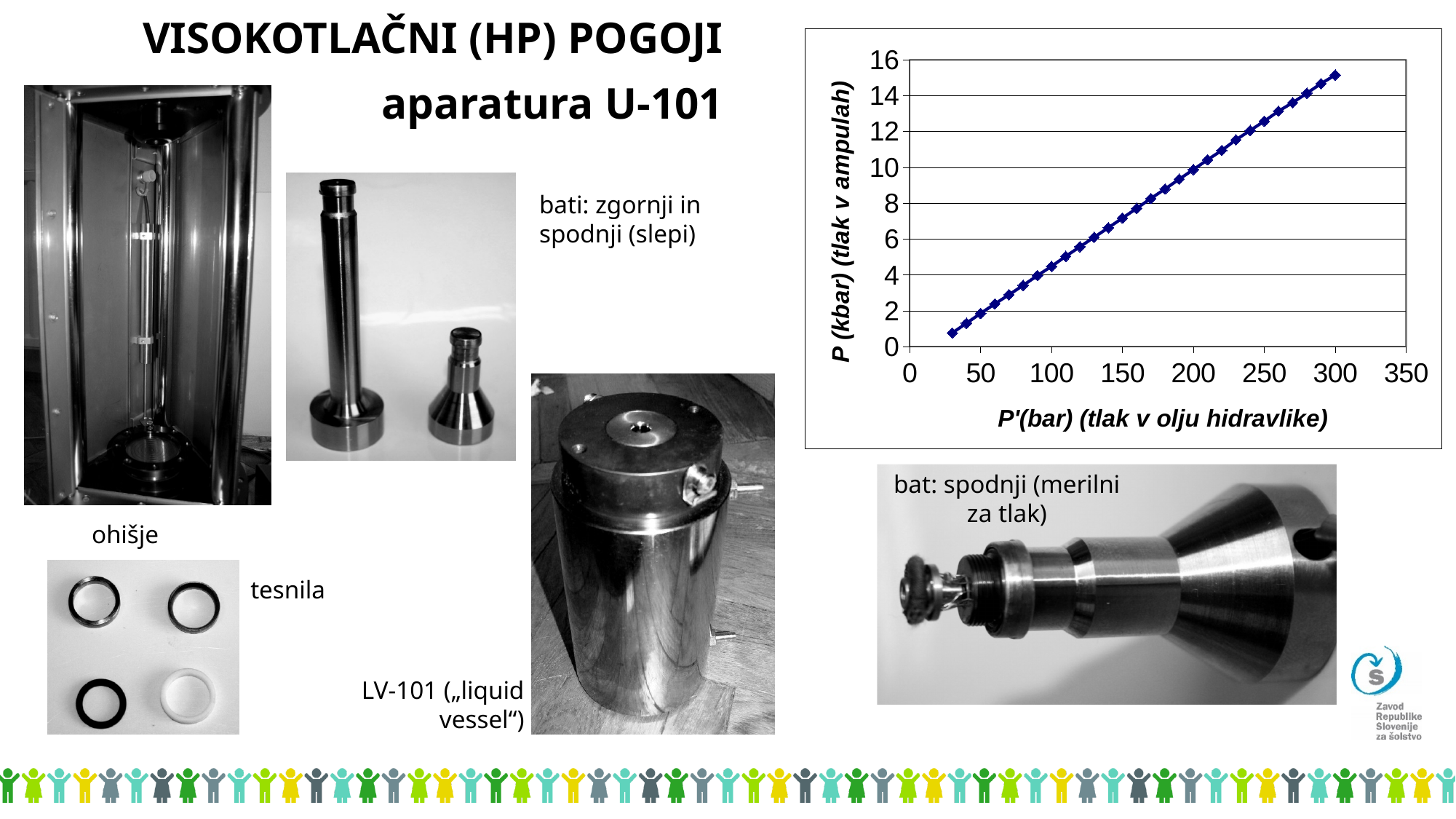
Is the value of P (kbar) at P'(bar) = 100 greater or less than 4? greater Is the value of P (kbar) at P'(bar) = 150 greater or less than 8? less Do the values of P (kbar) rise or fall as P'(bar) increases along the x axis? rise Is the value of P (kbar) at P'(bar) = 100 greater or less than 6? less What is the title of the chart's y axis? P (kbar) (tlak v ampulah) What is the title of the chart's x axis? P'(bar) (tlak v olju hidravlike) What kind of chart is shown on the slide? line chart Which has the larger P (kbar) value: the point at P'(bar) = 100 or the point at P'(bar) = 200? P'(bar) = 200